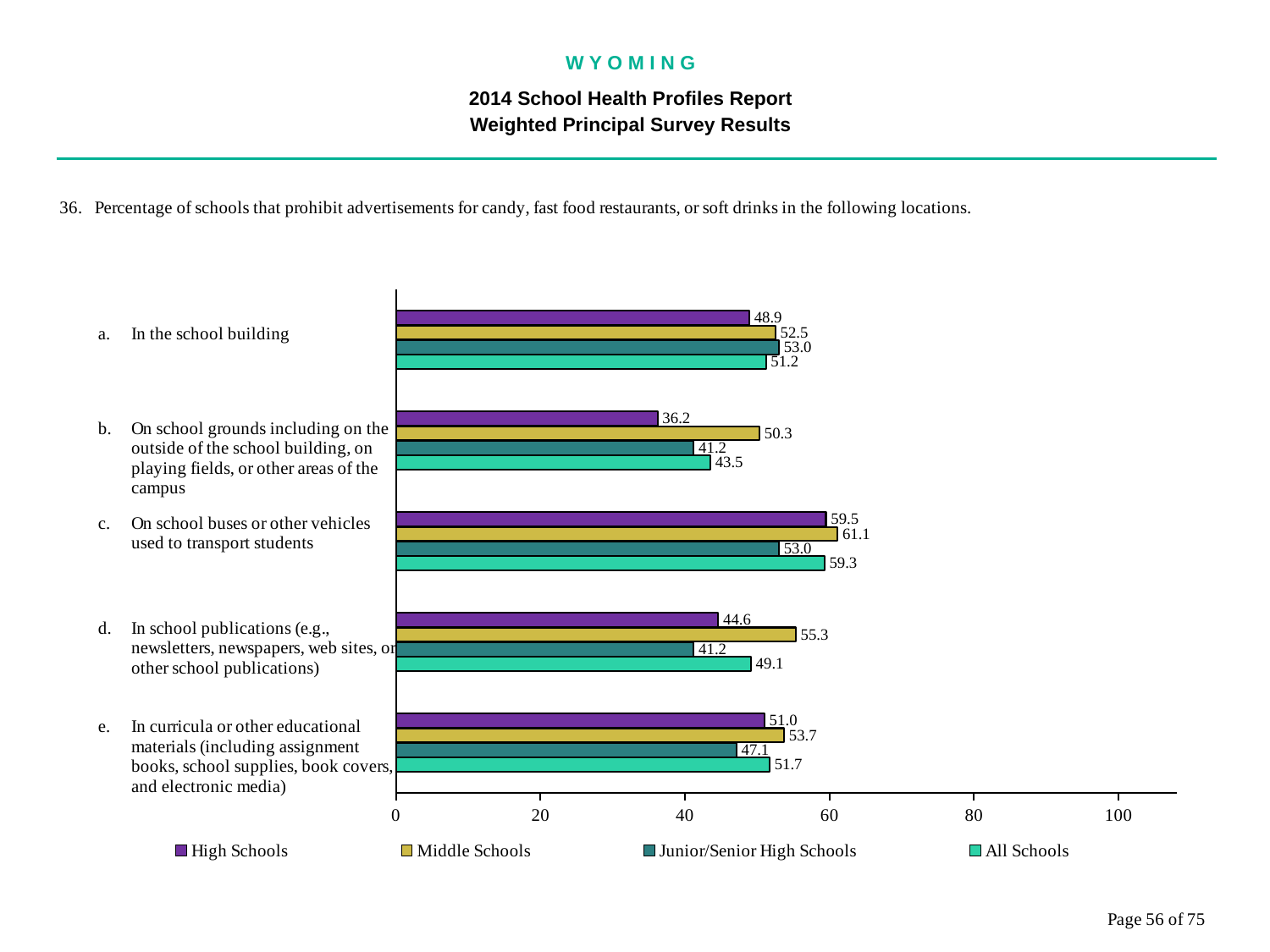
What is the value for All Schools for 'In curricula or other educational materials'? 51.7 What is the value for Junior/Senior High Schools for 'In school publications'? 41.2 How many locations (categories) are shown on the chart? 5 Which location has the highest value for High Schools? On school buses or other vehicles used to transport students What is the value for Middle Schools for 'On school buses or other vehicles used to transport students'? 61.1 How many series does the legend list? 4 What is the difference between the Middle Schools and High Schools values for 'On school grounds'? 14.1 For 'In school publications', which is larger: the Middle Schools value or the All Schools value? Middle Schools What is the value for High Schools for 'In the school building'? 48.9 Which location has the lowest value for High Schools? On school grounds including on the outside of the school building, on playing fields, or other areas of the campus What kind of chart is shown on the slide? Bar chart Which series is shown in the legend with a purple colour? High Schools